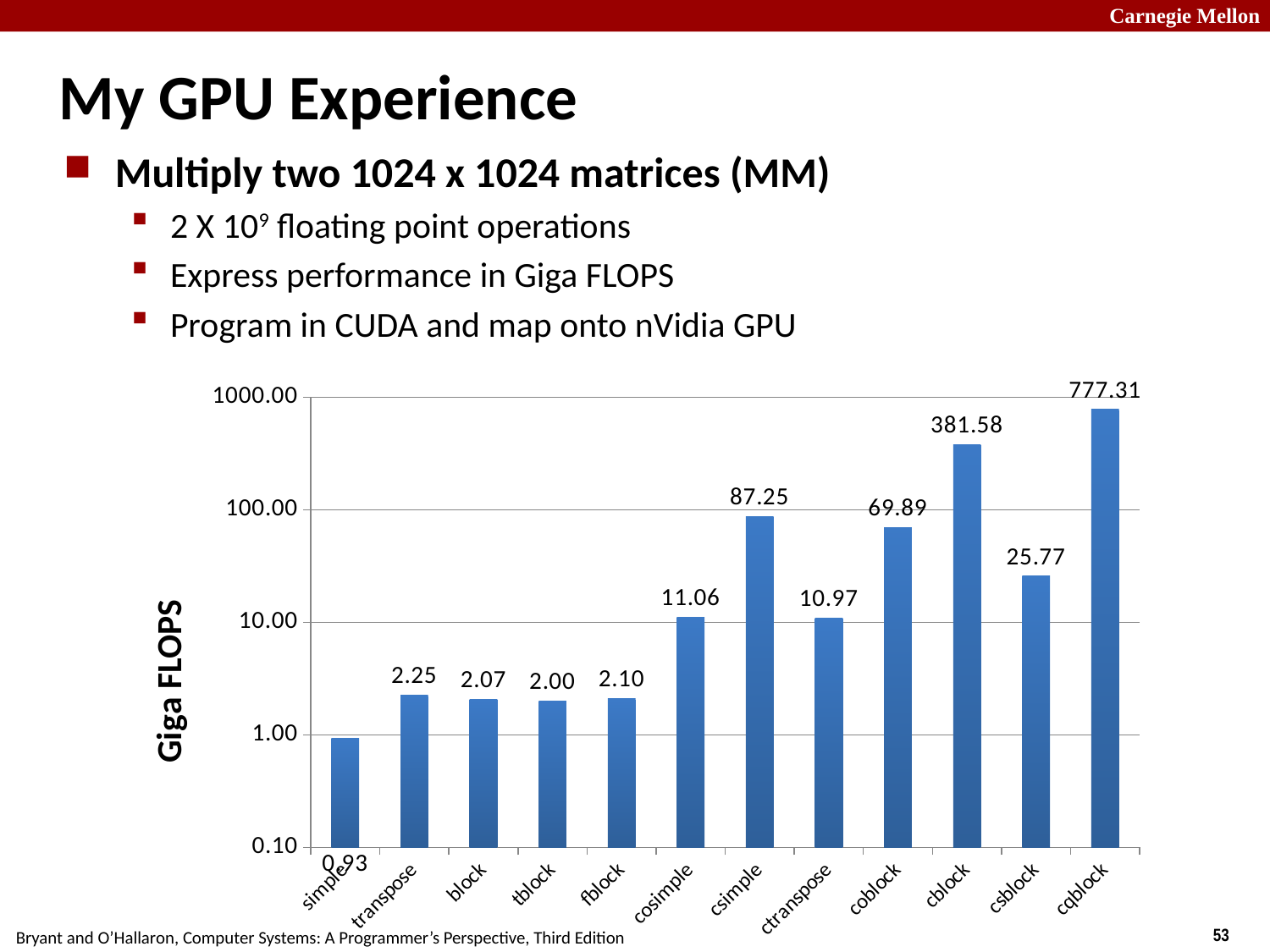
What is the Giga FLOPS value for csblock? 25.77 What is the Giga FLOPS value for ctranspose? 10.97 Which category has the highest Giga FLOPS value? cqblock What is the label of the vertical axis of the chart? Giga FLOPS Which category has the lowest Giga FLOPS value? simple What is the difference in Giga FLOPS between cqblock and cblock? 395.73 What is the Giga FLOPS value for cqblock? 777.31 Is the value for cblock greater or less than 100.00? greater Which has a higher Giga FLOPS value, csimple or coblock? csimple How many categories are shown on the x axis of the chart? 12 What is the Giga FLOPS value for csimple? 87.25 What kind of chart is shown on the slide? bar chart